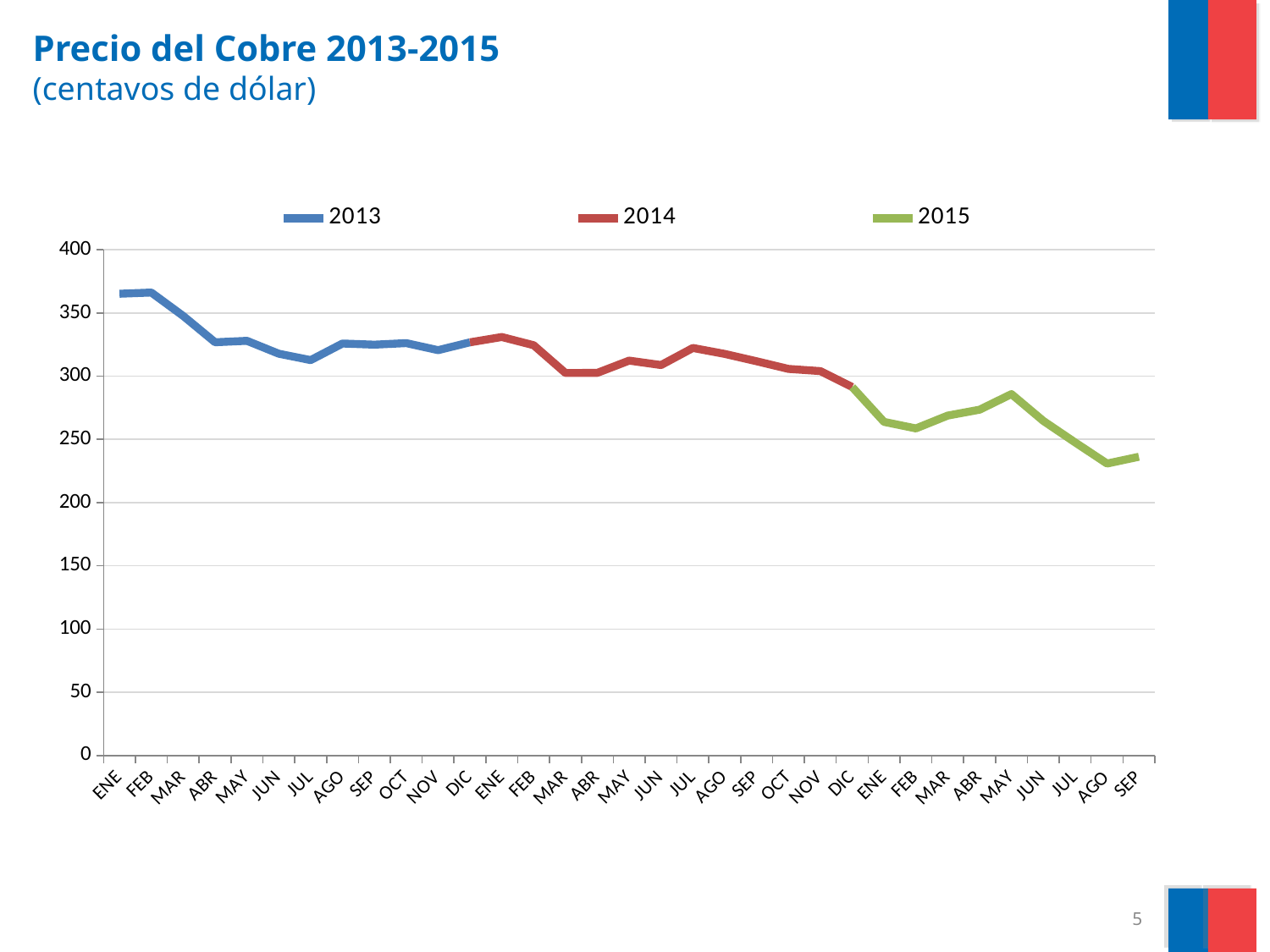
How many monthly points are plotted in total across all three series? 33 What kind of chart is shown on the slide? line chart Is the value for ENE 2013 greater or less than 350? greater Which years are listed in the legend? 2013, 2014, 2015 Which is larger, the value for ENE 2013 or the value for SEP 2015? ENE 2013 Is the value for AGO 2015 greater or less than 250? less How many series does the legend list? 3 Is the value for MAY 2015 greater or less than 300? less Overall, do the copper prices rise or fall from ENE 2013 to SEP 2015? fall What is the title of the chart? Precio del Cobre 2013-2015 (centavos de dólar) How many monthly points are plotted for the 2015 series? 10